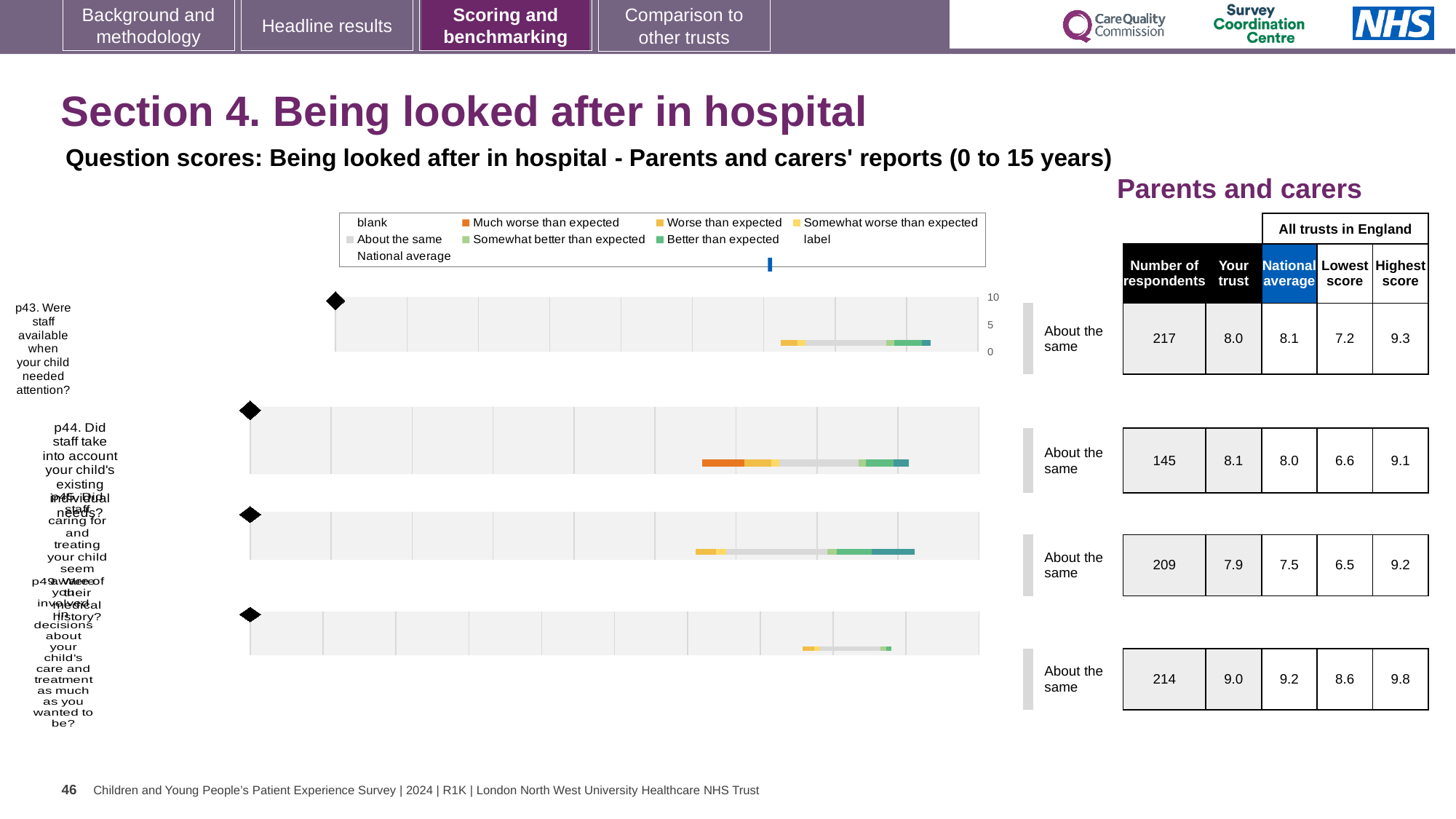
For the fourth chart (p49), what is the lowest score among all trusts in England? 8.6 For the third chart (p45), what is the difference between the 'Your trust' score and the national average? 0.4 How many question charts are shown on the slide? 4 Which of the four questions has the fewest respondents? p44 Which of the four questions has the highest 'Your trust' score? p49 For the first chart (p43), how many respondents are listed in the table? 217 For the fourth chart (p49), is the 'Your trust' score or the national average larger? National average For the third chart (p45), what is the highest score among all trusts in England? 9.2 For the first chart (p43, were staff available when your child needed attention), what is the 'Your trust' score shown in the table? 8.0 What benchmark category is shown next to each of the four charts? About the same For the second chart (p44), what is the national average score shown in the table? 8.0 What kind of chart is used to show each question's score? Bar chart